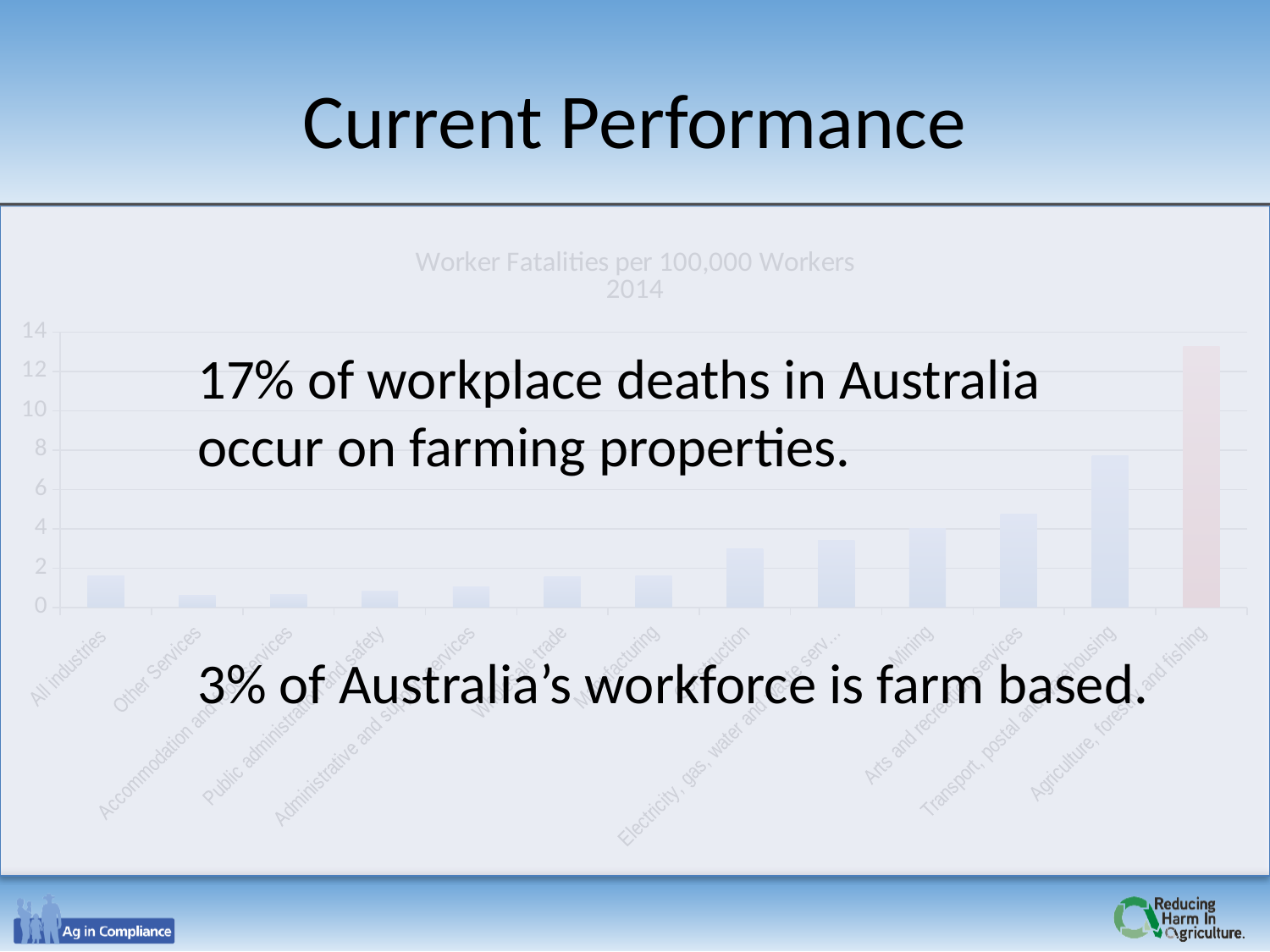
How many industry categories are plotted in the chart? 13 Do the bar values generally rise or fall from left to right across the chart? rise Which industry has the highest worker fatality rate in the chart? Agriculture, forestry and fishing Is the value for Agriculture, forestry and fishing greater or less than 12? greater Which has a higher fatality rate, Transport, postal and warehousing or Mining? Transport, postal and warehousing Which bar is shown in a different colour (red) from the rest? Agriculture, forestry and fishing Is the value for Mining greater or less than 6? less What is the title of the chart? Worker Fatalities per 100,000 Workers 2014 Is the value for All industries greater or less than 4? less What kind of chart is shown on the slide? Bar chart